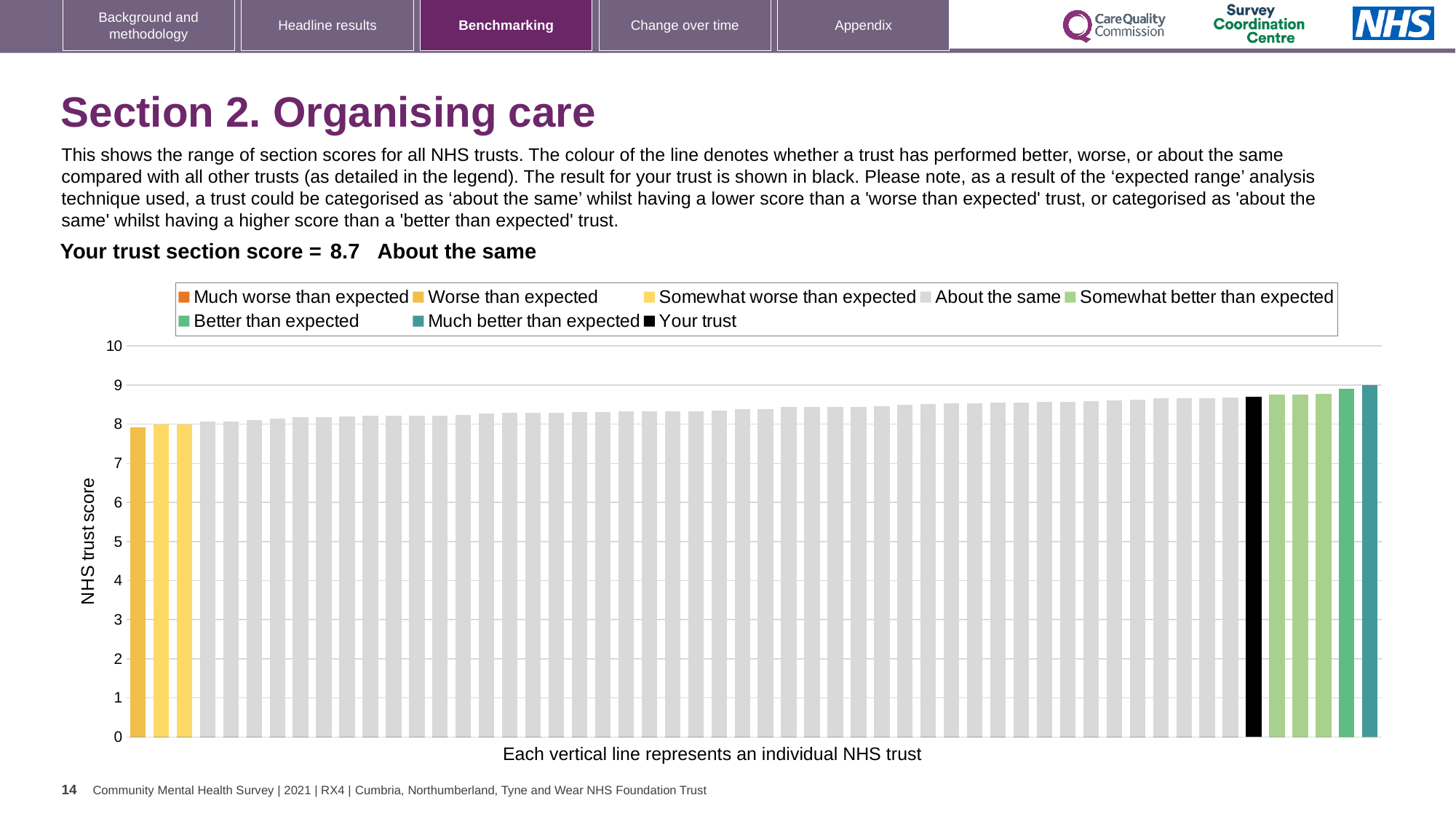
Which legend category does the tallest bar belong to? Much better than expected What kind of chart is shown on the slide? Bar chart Which category is your trust placed in for this section? About the same Are there any bars in the 'Much worse than expected' category on the chart? No Which is taller, the leftmost bar or the rightmost bar? the rightmost bar Is the value of the black 'Your trust' bar greater or less than 8? greater What colour is the bar representing your trust? Black Do the bar values rise or fall from left to right along the x axis? rise Is the value of the leftmost bar greater or less than 7? greater What is the section score for your trust shown on the slide? 8.7 What is the label on the y axis of the chart? NHS trust score How many entries does the chart legend list? 8